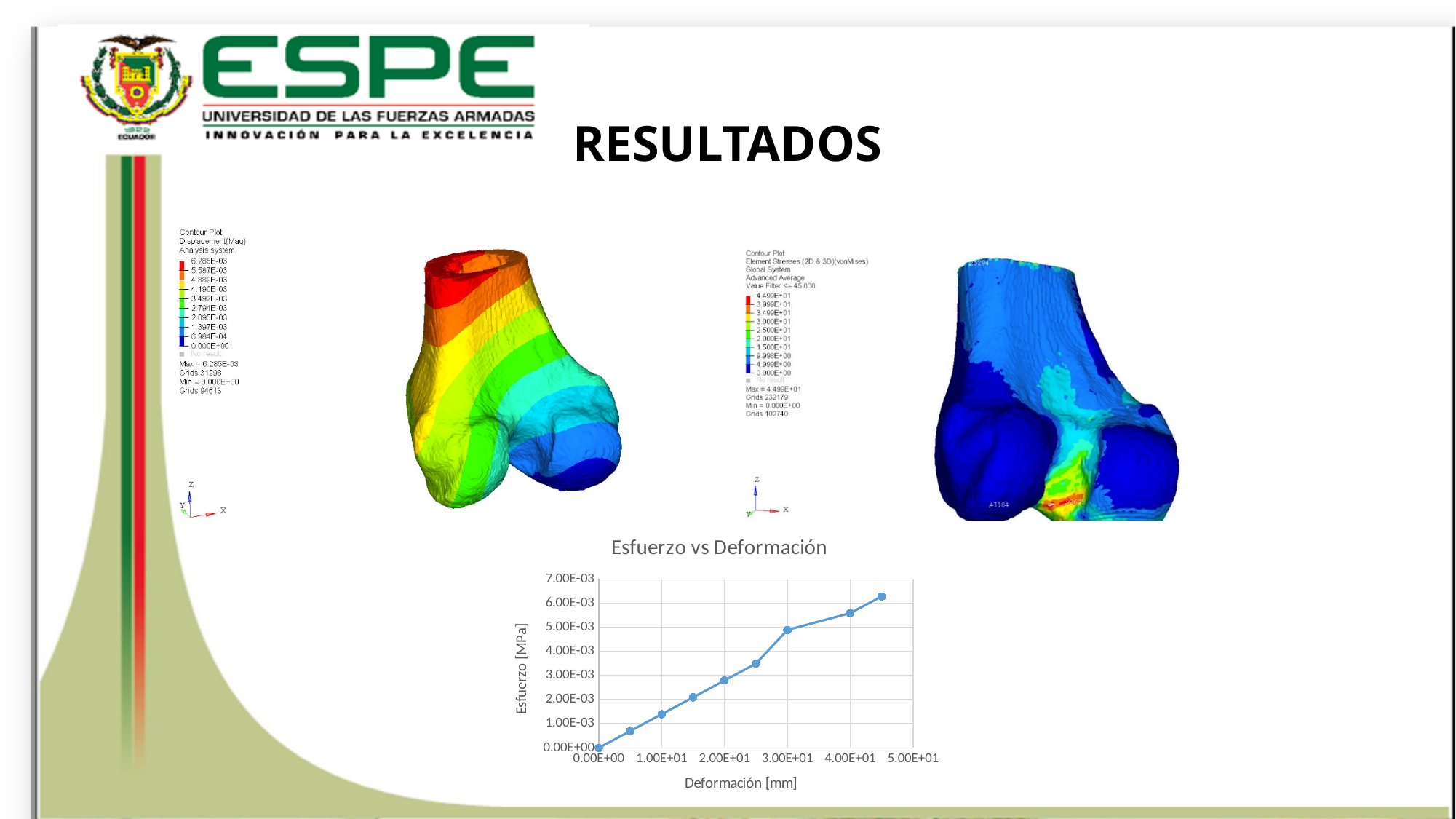
On the 'Esfuerzo vs Deformación' chart, do the values rise or fall as Deformación increases? rise On the 'Esfuerzo vs Deformación' chart, is the Esfuerzo value at Deformación 3.00E+01 greater or less than 4.00E-03? greater What is the label of the y axis on the 'Esfuerzo vs Deformación' chart? Esfuerzo [MPa] On the 'Esfuerzo vs Deformación' chart, is the Esfuerzo value at Deformación 1.00E+01 greater or less than 2.00E-03? less On the 'Esfuerzo vs Deformación' chart, what is the Esfuerzo value at Deformación 0.00E+00? 0.00E+00 On the 'Esfuerzo vs Deformación' chart, at which Deformación value is the Esfuerzo lowest? 0.00E+00 On the 'Esfuerzo vs Deformación' chart, which has the larger Esfuerzo value: Deformación 2.00E+01 or Deformación 3.00E+01? 3.00E+01 What kind of chart is the 'Esfuerzo vs Deformación' chart? line chart On the 'Esfuerzo vs Deformación' chart, is the Esfuerzo value at Deformación 4.00E+01 greater or less than 5.00E-03? greater How many data points are plotted on the 'Esfuerzo vs Deformación' chart? 9 What is the title of the chart at the bottom of the slide? Esfuerzo vs Deformación